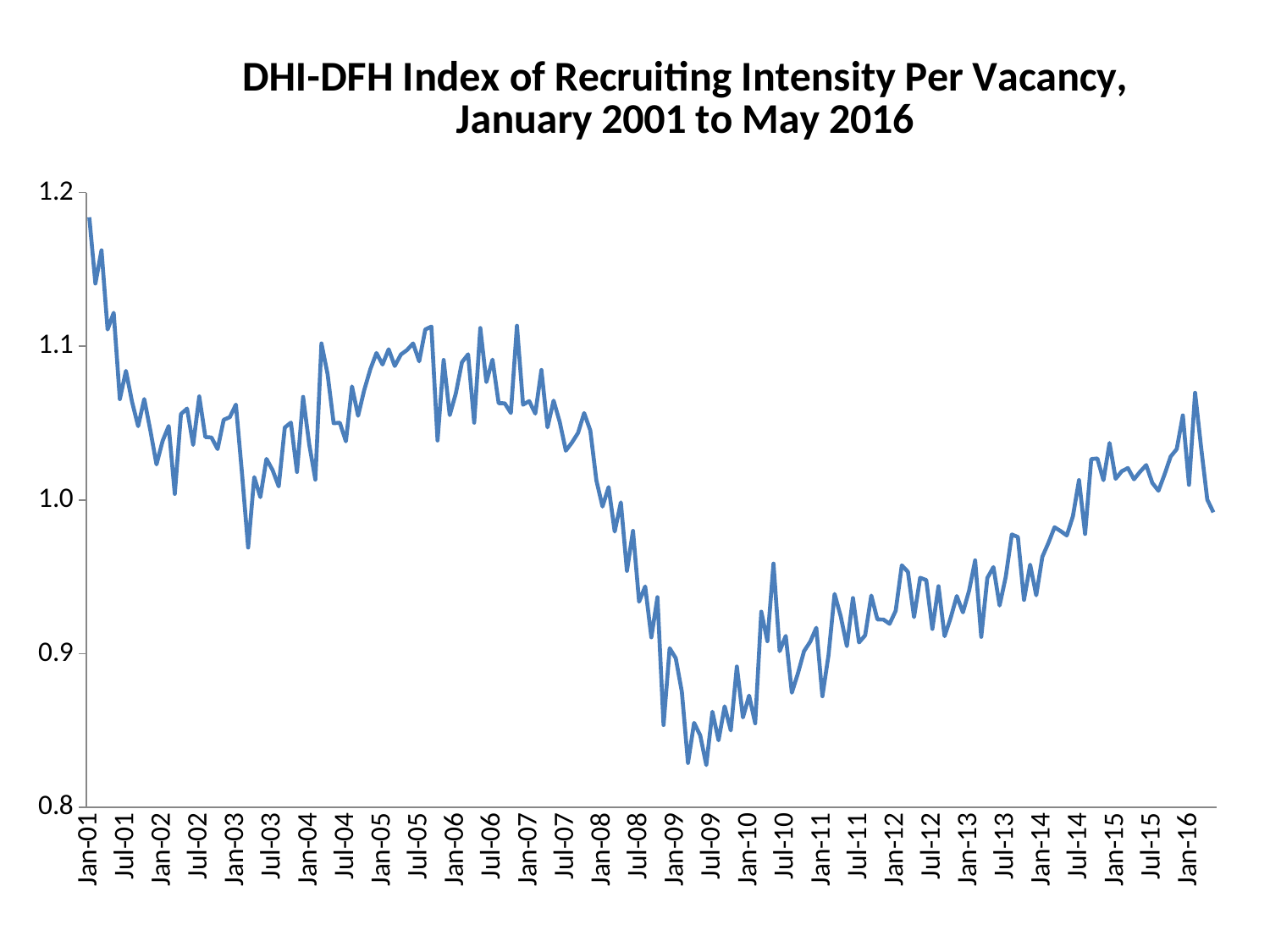
What is the title of the chart? DHI-DFH Index of Recruiting Intensity Per Vacancy, January 2001 to May 2016 Which is larger, the value for Jan-01 or the value for Jan-09? Jan-01 Does the index generally rise or fall between Jan-07 and Jan-09? fall Is the value for Jan-15 greater or less than 1.0? greater At which date does the index reach its highest point? Jan-01 Is the value for Jan-05 greater or less than 1.0? greater How many data series are plotted on the chart? 1 Is the value for Jan-01 greater or less than 1.1? greater In which year does the index reach its lowest point? 2009 What kind of chart is shown on the slide? line chart